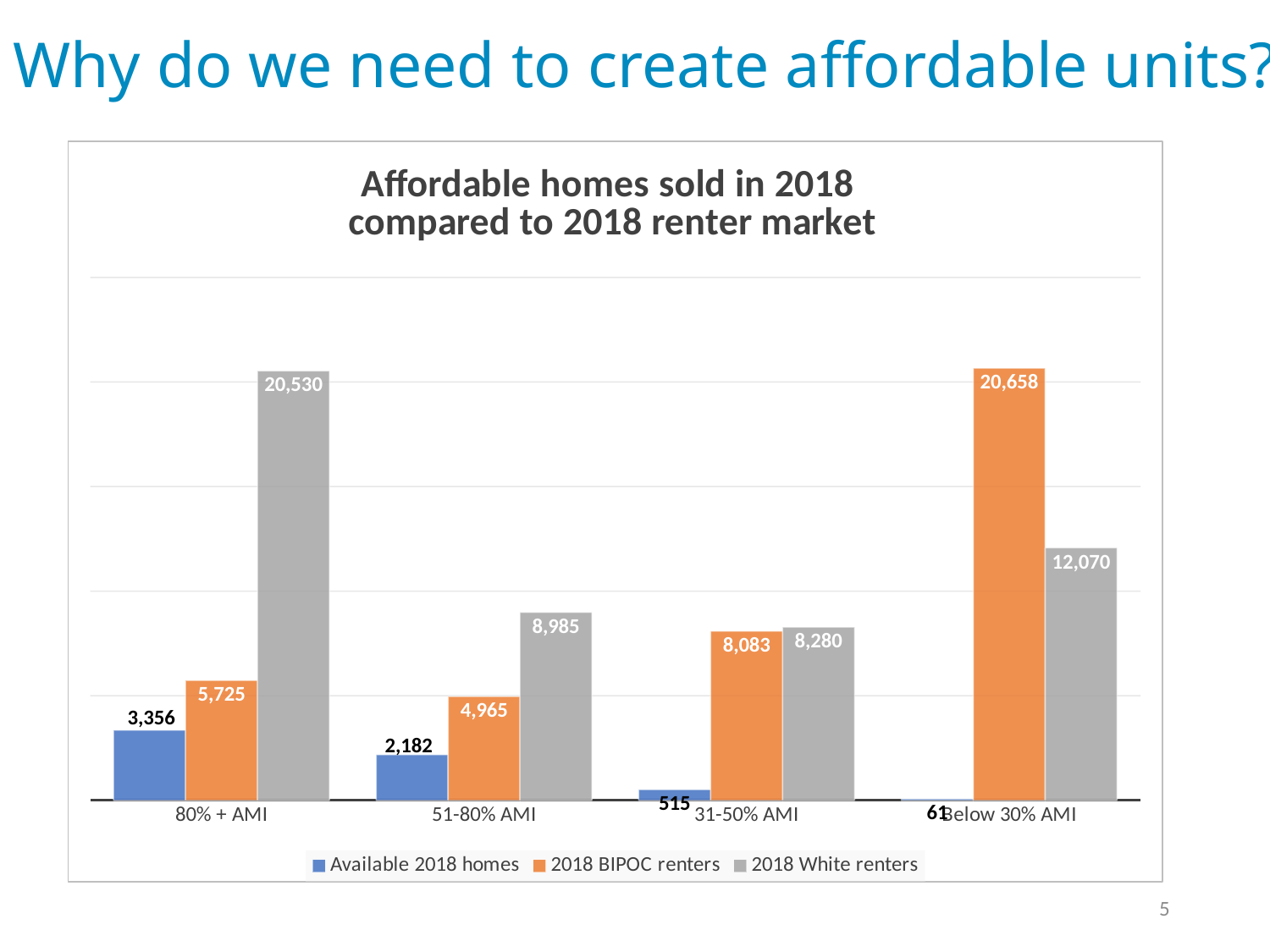
What is the value for Available 2018 homes in the 31-50% AMI category? 515 Which category has the lowest value for 2018 BIPOC renters? 51-80% AMI What is the value for Available 2018 homes in the 51-80% AMI category? 2,182 How many AMI categories are shown on the x axis? 4 Which category has the highest value for Available 2018 homes? 80% + AMI What is the value for 2018 White renters in the 80% + AMI category? 20,530 What kind of chart is shown on the slide? Bar chart What is the value for 2018 BIPOC renters in the Below 30% AMI category? 20,658 How many series does the legend list? 3 What is the difference between 2018 BIPOC renters and 2018 White renters in the Below 30% AMI category? 8,588 Do the values for Available 2018 homes rise or fall moving from 80% + AMI to Below 30% AMI? Fall In the 51-80% AMI category, which is larger: 2018 BIPOC renters or 2018 White renters? 2018 White renters